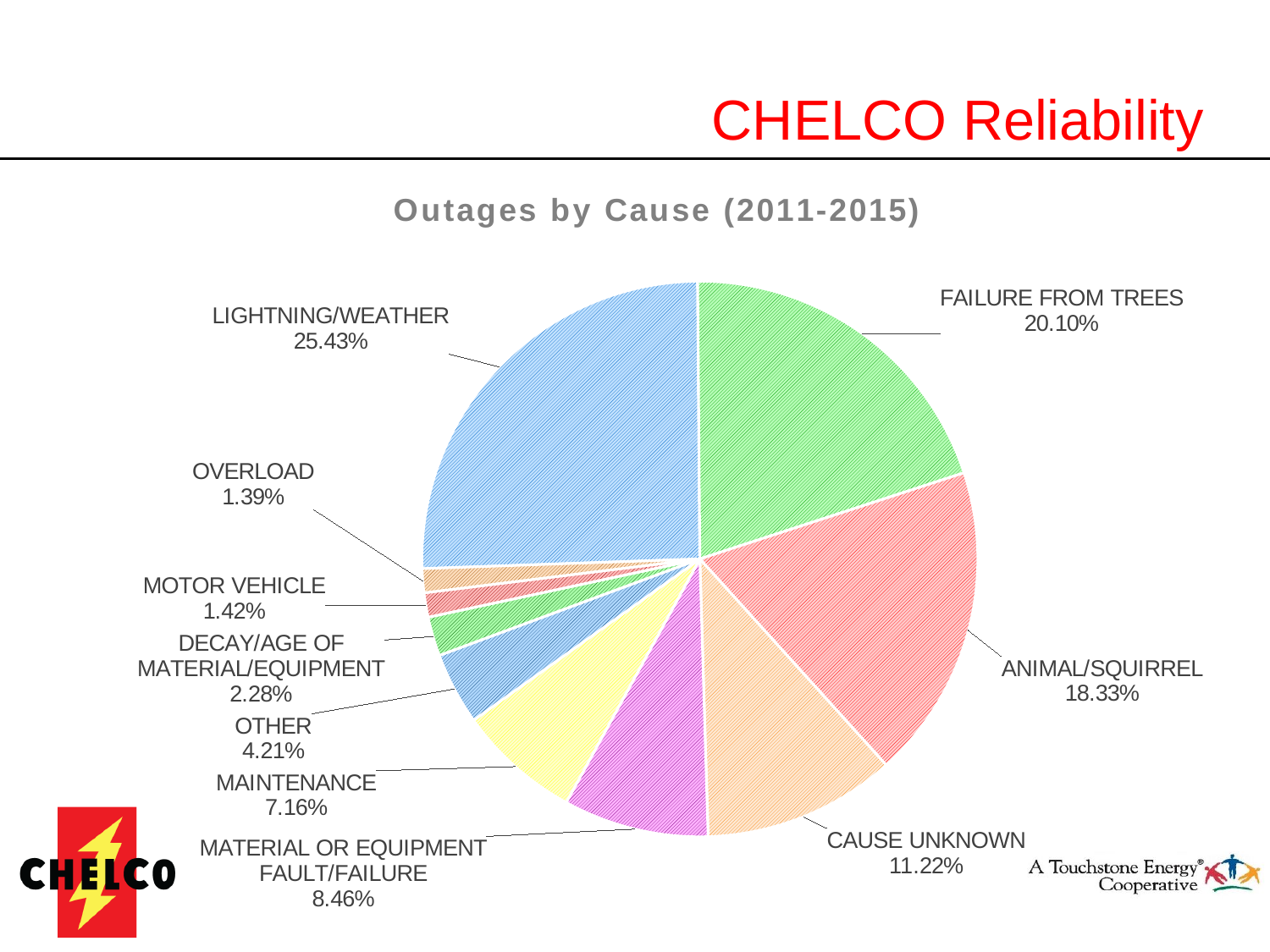
What percentage of outages is attributed to LIGHTNING/WEATHER? 25.43% What is the title of the chart? Outages by Cause (2011-2015) What is the combined share of LIGHTNING/WEATHER and FAILURE FROM TREES? 45.53% What percentage of outages is attributed to MAINTENANCE? 7.16% Which is larger: the share for OTHER or the share for DECAY/AGE OF MATERIAL/EQUIPMENT? OTHER What percentage of outages is attributed to ANIMAL/SQUIRREL? 18.33% What share of outages is labelled CAUSE UNKNOWN? 11.22% What is the difference in percentage points between FAILURE FROM TREES and ANIMAL/SQUIRREL? 1.77 How many causes (slices) are shown in the pie chart? 10 Which cause accounts for the smallest share of outages? OVERLOAD What type of chart is shown on the slide? Pie chart Which cause accounts for the largest share of outages? LIGHTNING/WEATHER